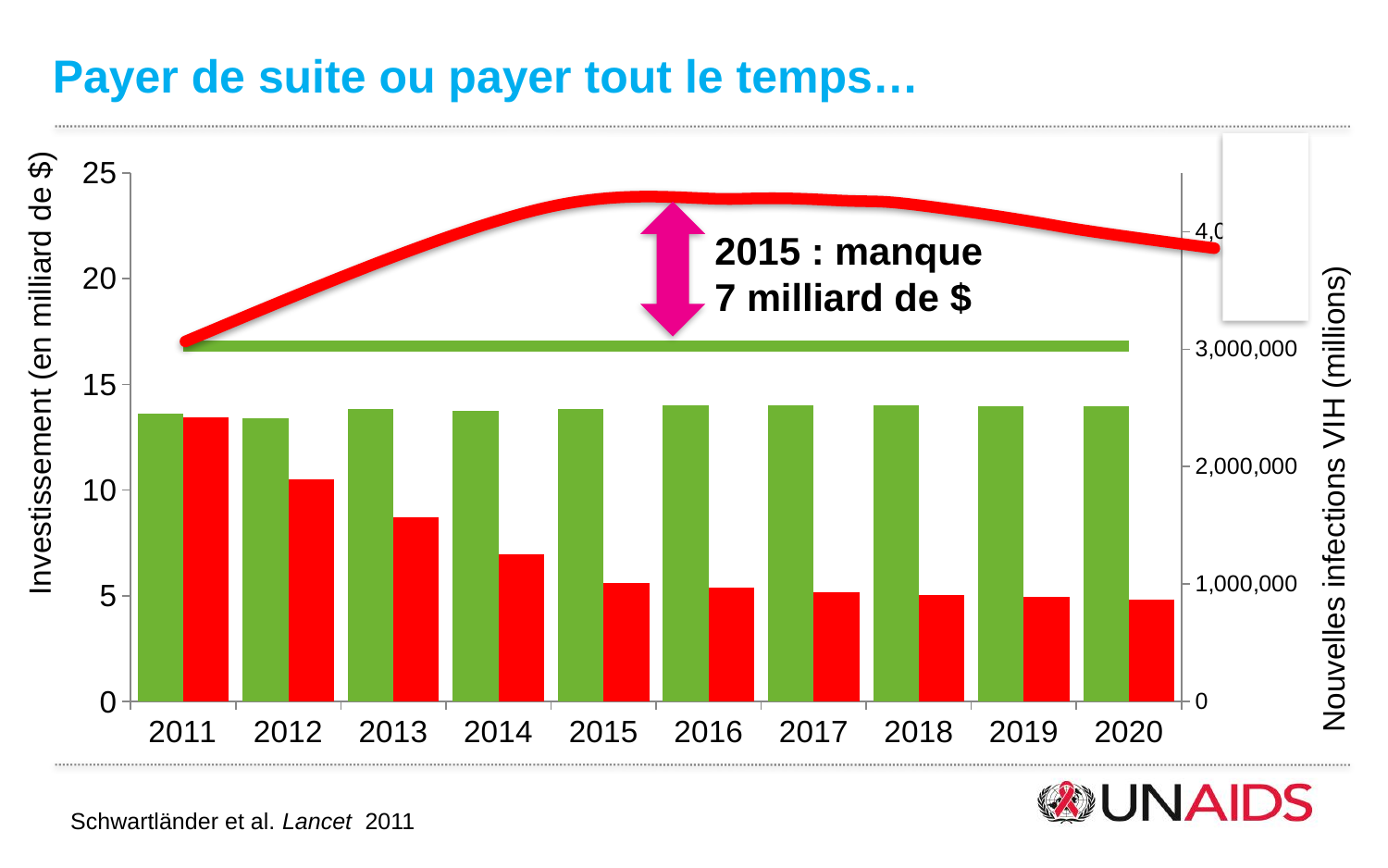
In 2020, which bar is taller, the green bar or the red bar? The green bar Is the red line at its peak around 2016 greater or less than 20 on the left axis? greater Is the red bar for 2011 greater or less than 10 on the left axis? greater What is the first year shown on the x axis of the chart? 2011 Do the red bars rise or fall from 2011 to 2020? Fall Is the green bar for 2016 greater or less than 15 on the left axis? less What kind of chart is shown on the slide? A bar chart combined with line series How many years are shown on the x axis of the chart? 10 What is the last year shown on the x axis of the chart? 2020 Which year has the tallest red bar? 2011 What is the title of the left vertical axis of the chart? Investissement (en milliard de $)